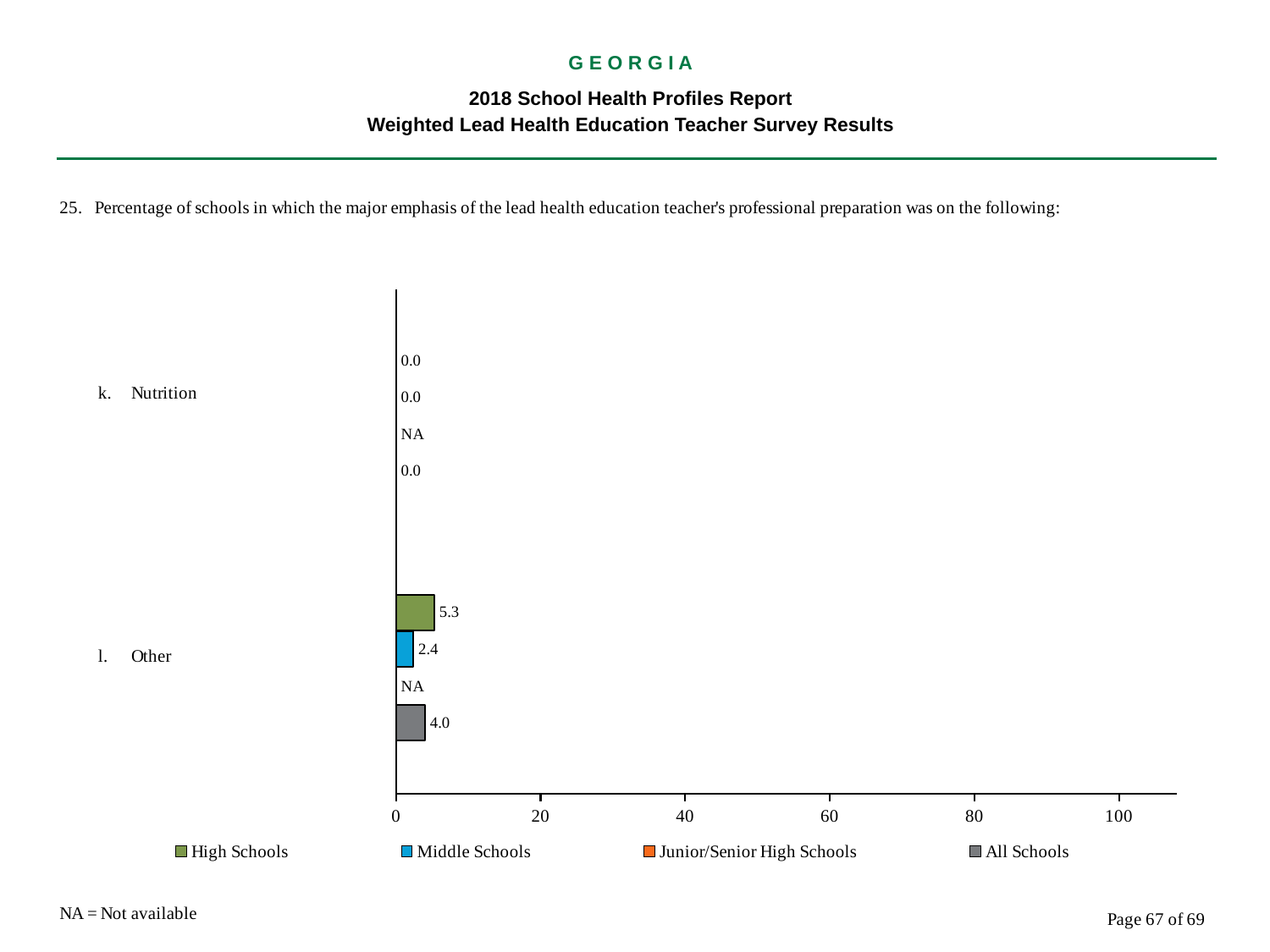
Is the value for High Schools in the Other category greater or less than 20? less What is the value for Middle Schools in the Other category? 2.4 What is the value for High Schools in the Other category? 5.3 What kind of chart is shown on the slide? bar chart What is the value for All Schools in the Other category? 4.0 Which is larger in the Other category, the All Schools value or the Middle Schools value? All Schools How many series does the legend list? 4 What is the value for High Schools in the Nutrition category? 0.0 What is the difference between the High Schools and Middle Schools values in the Other category? 2.9 How many categories are shown on the chart? 2 What is shown for Junior/Senior High Schools in the Other category? NA Which series has the highest value in the Other category? High Schools